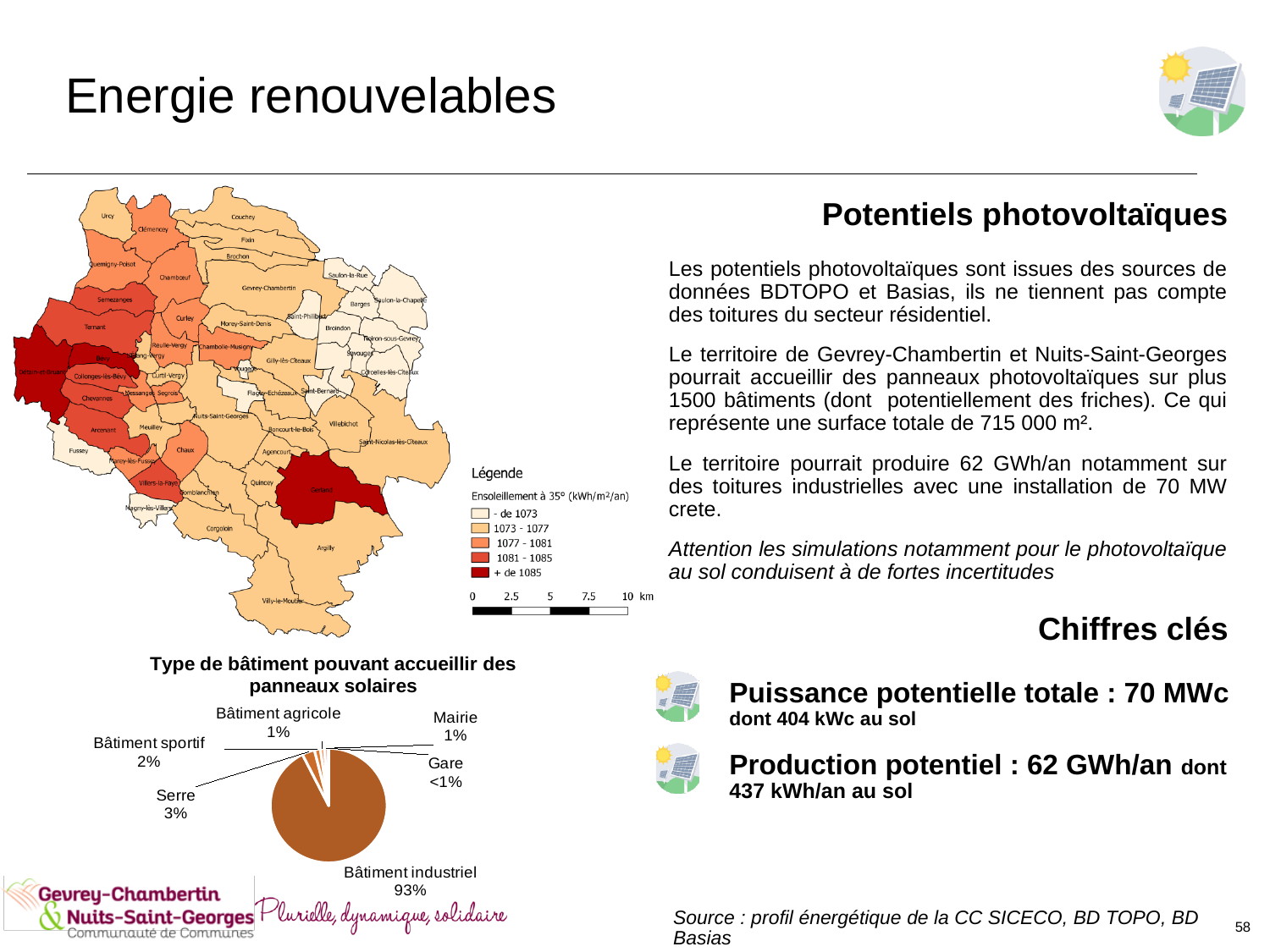
In the pie chart 'Type de bâtiment pouvant accueillir des panneaux solaires', what is the value for Gare? <1% What kind of chart is 'Type de bâtiment pouvant accueillir des panneaux solaires'? Pie chart In the pie chart 'Type de bâtiment pouvant accueillir des panneaux solaires', what is the difference between the shares of Bâtiment industriel and Serre? 90% In the pie chart 'Type de bâtiment pouvant accueillir des panneaux solaires', what is the value for Bâtiment agricole? 1% What share of the pie chart 'Type de bâtiment pouvant accueillir des panneaux solaires' is Bâtiment industriel? 93% In the pie chart 'Type de bâtiment pouvant accueillir des panneaux solaires', what is the value for Serre? 3% What is the title of the pie chart at the bottom left of the slide? Type de bâtiment pouvant accueillir des panneaux solaires Which category has the largest share in the pie chart 'Type de bâtiment pouvant accueillir des panneaux solaires'? Bâtiment industriel How many categories are shown in the pie chart 'Type de bâtiment pouvant accueillir des panneaux solaires'? 6 In the pie chart 'Type de bâtiment pouvant accueillir des panneaux solaires', what is the value for Bâtiment sportif? 2% In the pie chart 'Type de bâtiment pouvant accueillir des panneaux solaires', which is larger: Serre or Bâtiment sportif? Serre Which category has the smallest share in the pie chart 'Type de bâtiment pouvant accueillir des panneaux solaires'? Gare